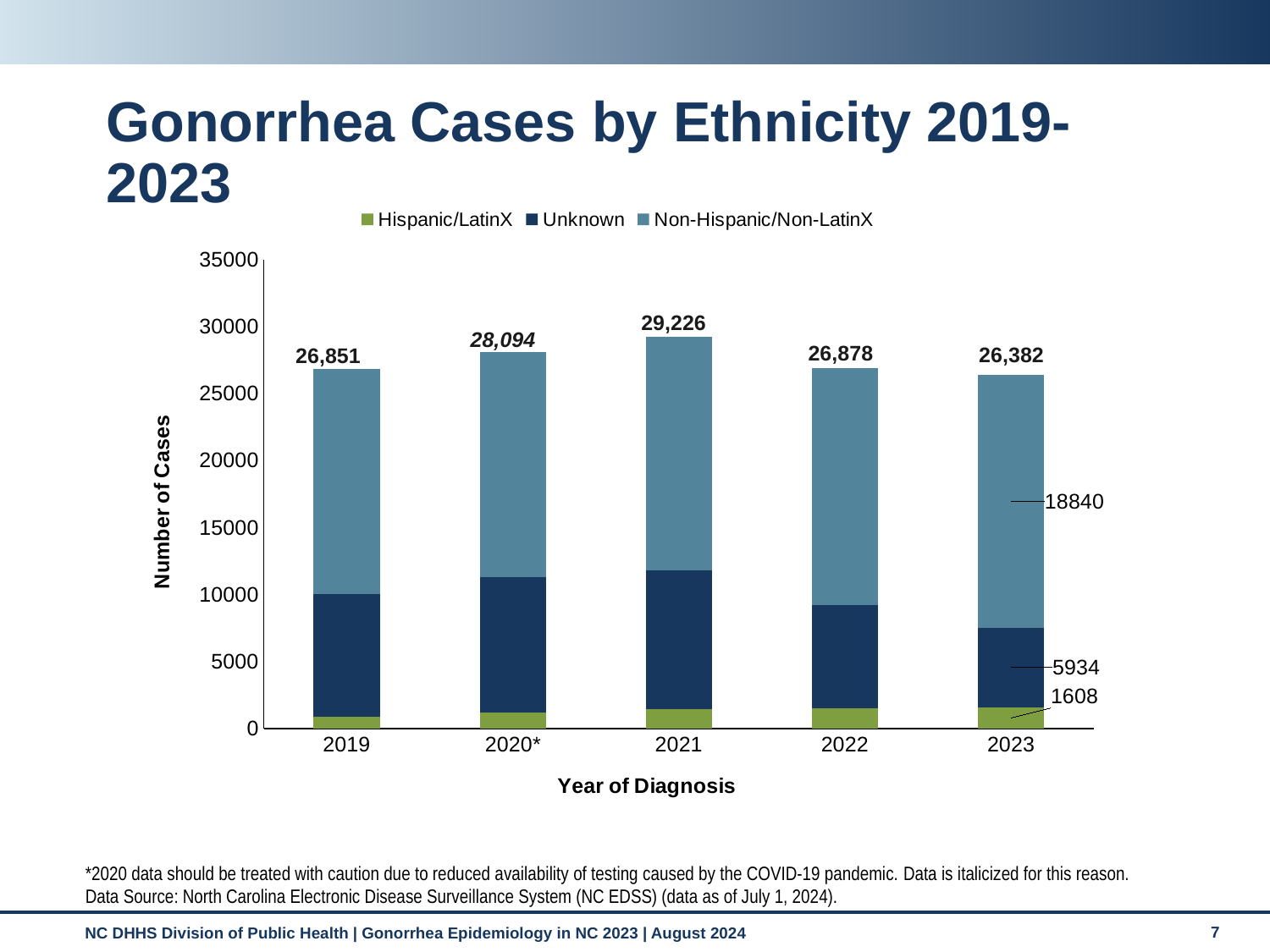
What is the difference between the total cases in 2021 and 2019? 2,375 What is the total number of gonorrhea cases shown for 2021? 29,226 Which year has a larger total of cases, 2022 or 2023? 2022 What is the total number of cases labeled for 2019? 26,851 How many series does the legend list? 3 Which year has the lowest total number of cases? 2023 Which year has the highest total number of cases? 2021 Is the Hispanic/LatinX value for 2019 greater or less than 5000? less How many Non-Hispanic/Non-LatinX cases are labeled for 2023? 18840 How many Hispanic/LatinX cases are labeled for 2023? 1608 What kind of chart is shown on the slide? Stacked bar chart How many Unknown ethnicity cases are labeled for 2023? 5934